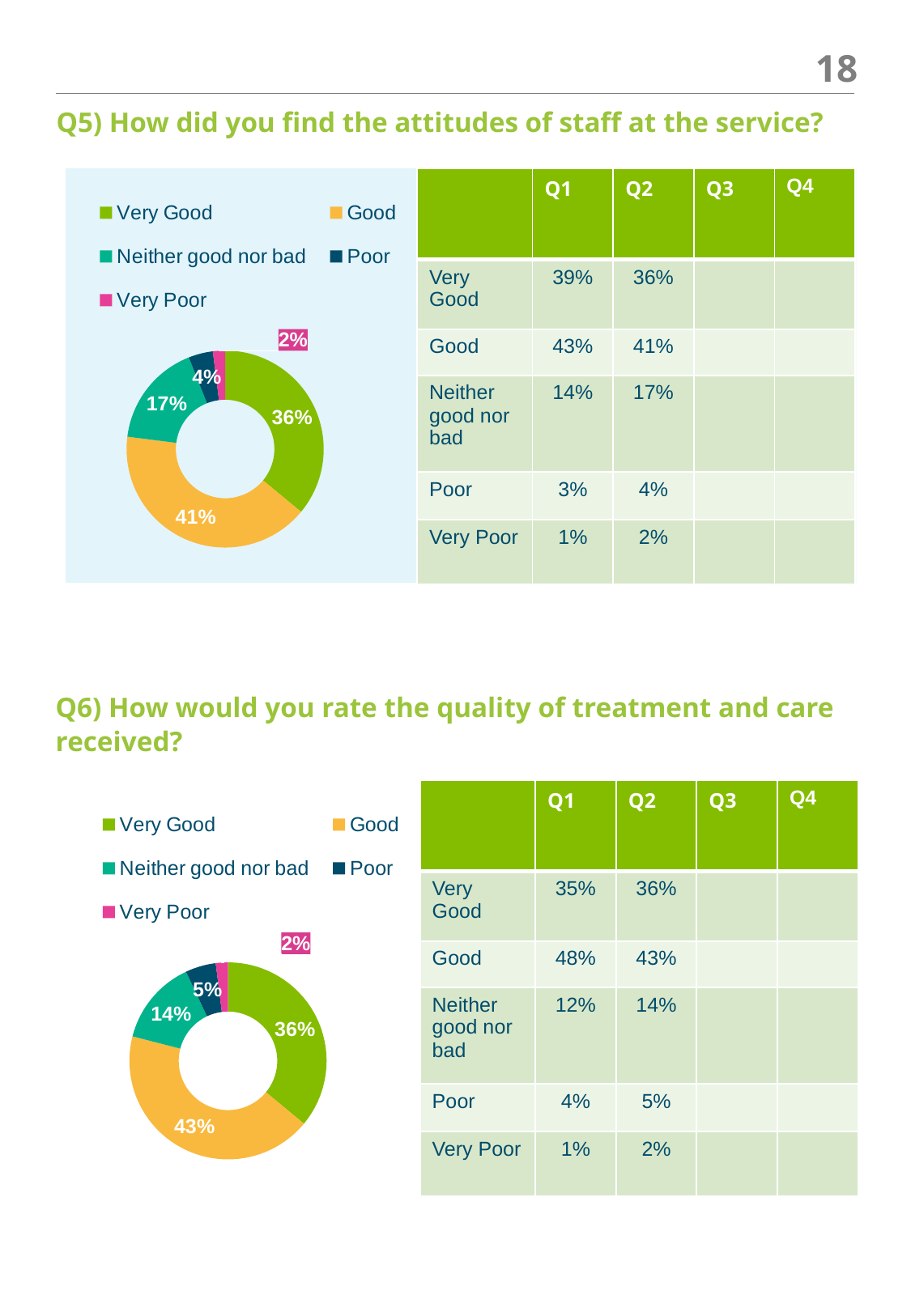
In the Q5 chart (attitudes of staff), which category has the largest slice? Good In the Q5 chart (attitudes of staff), which category has the smallest slice? Very Poor In the Q6 chart (quality of treatment and care), what share is labelled for Good? 43% In the Q6 chart (quality of treatment and care), what share is labelled for Poor? 5% In the Q5 chart (attitudes of staff), which colour represents Very Poor in the legend? Pink In the Q6 chart (quality of treatment and care), what is the difference between the Good and Neither good nor bad shares? 29% In the Q6 chart (quality of treatment and care), which is larger, the Neither good nor bad slice or the Poor slice? Neither good nor bad In the Q5 chart (attitudes of staff), what share is labelled for Good? 41% In the Q5 chart (attitudes of staff), how many categories does the legend list? 5 In the Q5 chart (attitudes of staff), what is the difference between the Good and Very Good shares? 5% What kind of chart is used for Q6 (quality of treatment and care)? Doughnut (pie) chart In the Q5 chart (attitudes of staff), what share is labelled for Neither good nor bad? 17%